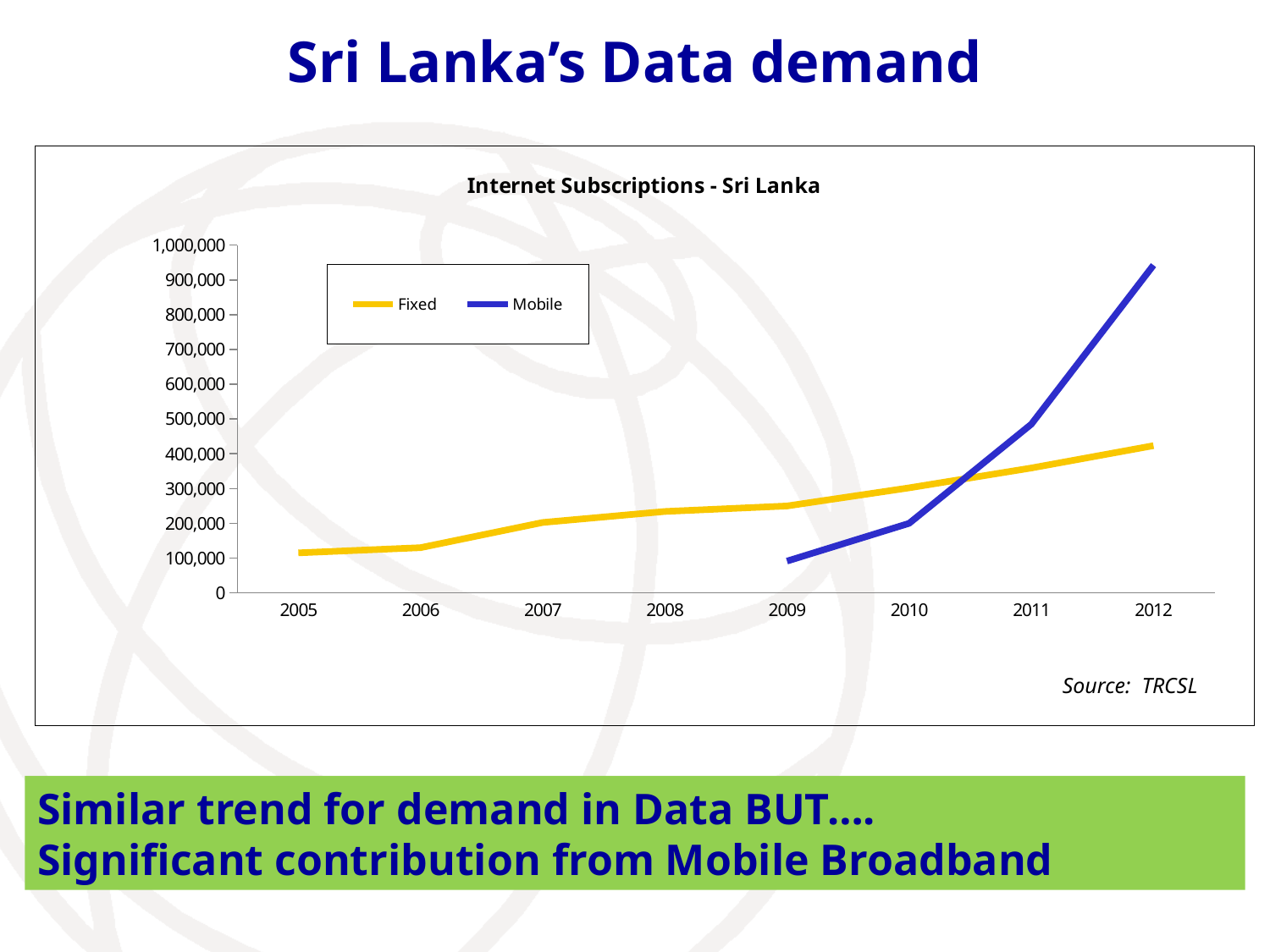
How many years are shown on the x axis? 8 What is the title of the chart? Internet Subscriptions - Sri Lanka In which year does the Mobile series reach its highest value? 2012 Is the value for Mobile in 2012 greater or less than 900,000? greater What kind of chart is shown on the slide? line chart Which series has the higher value in 2009, Fixed or Mobile? Fixed Is the value for Fixed in 2005 greater or less than 200,000? less Which series has the higher value in 2012, Fixed or Mobile? Mobile Do Fixed subscriptions rise or fall from 2005 to 2012? rise Which series is drawn in blue? Mobile How many series does the legend list? 2